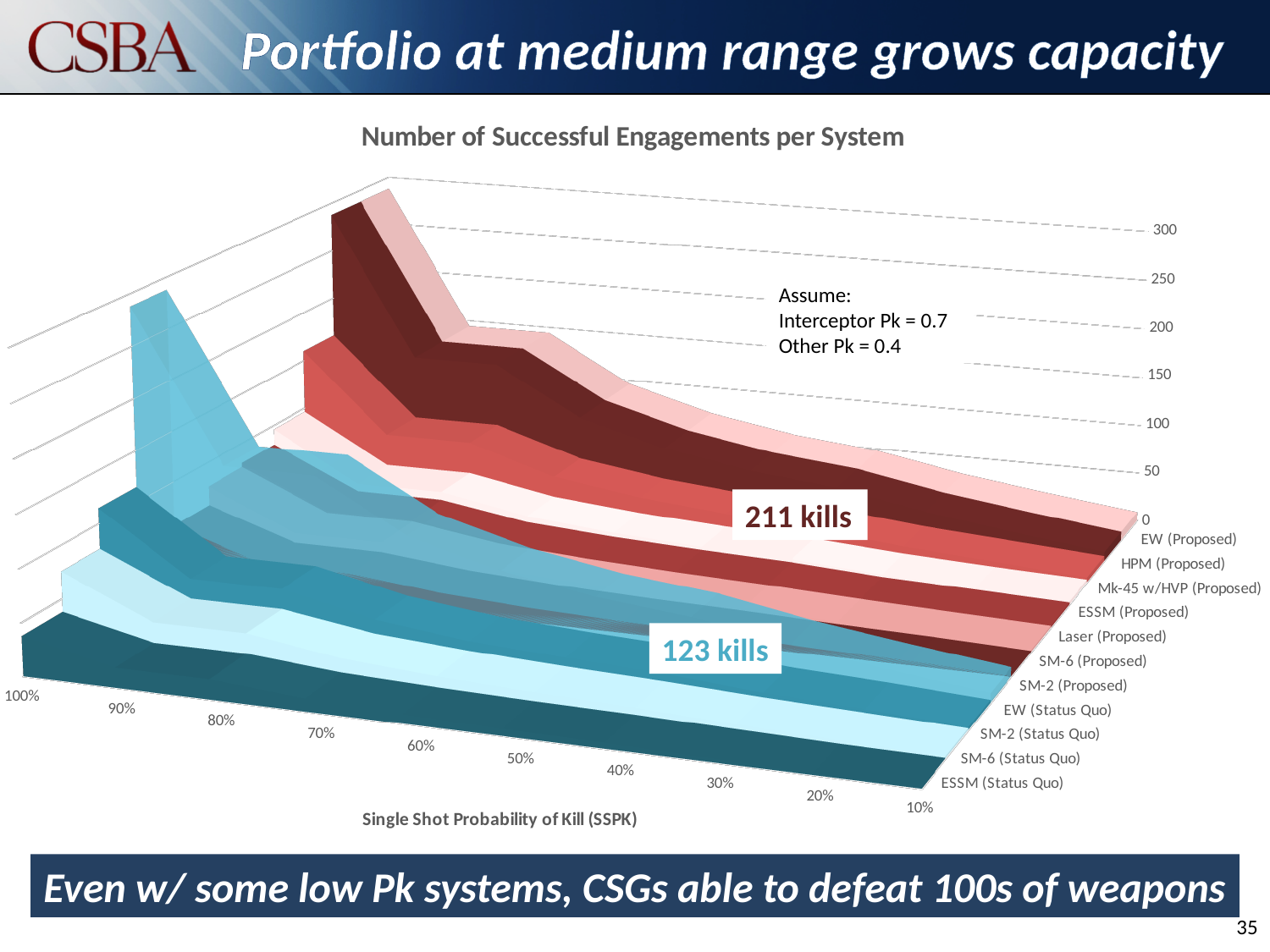
How many systems are listed along the depth axis of the chart? 11 Do the number of successful engagements rise or fall as SSPK goes from 100% to 10%? Fall Which system is listed at the back of the depth axis, next to the 0 tick? EW (Proposed) What is the highest value shown on the vertical axis? 300 How many SSPK tick labels are shown on the x axis? 10 Which portfolio has the larger annotated kill count, proposed or status quo? Proposed How many of the listed systems are labelled 'Status Quo'? 4 How many kills are annotated for the proposed (red) portfolio? 211 kills What interceptor Pk is assumed according to the note on the chart? 0.7 What is the difference between the 211 kills and 123 kills annotations? 88 How many kills are annotated for the status quo (blue) portfolio? 123 kills What is the title of the chart? Number of Successful Engagements per System